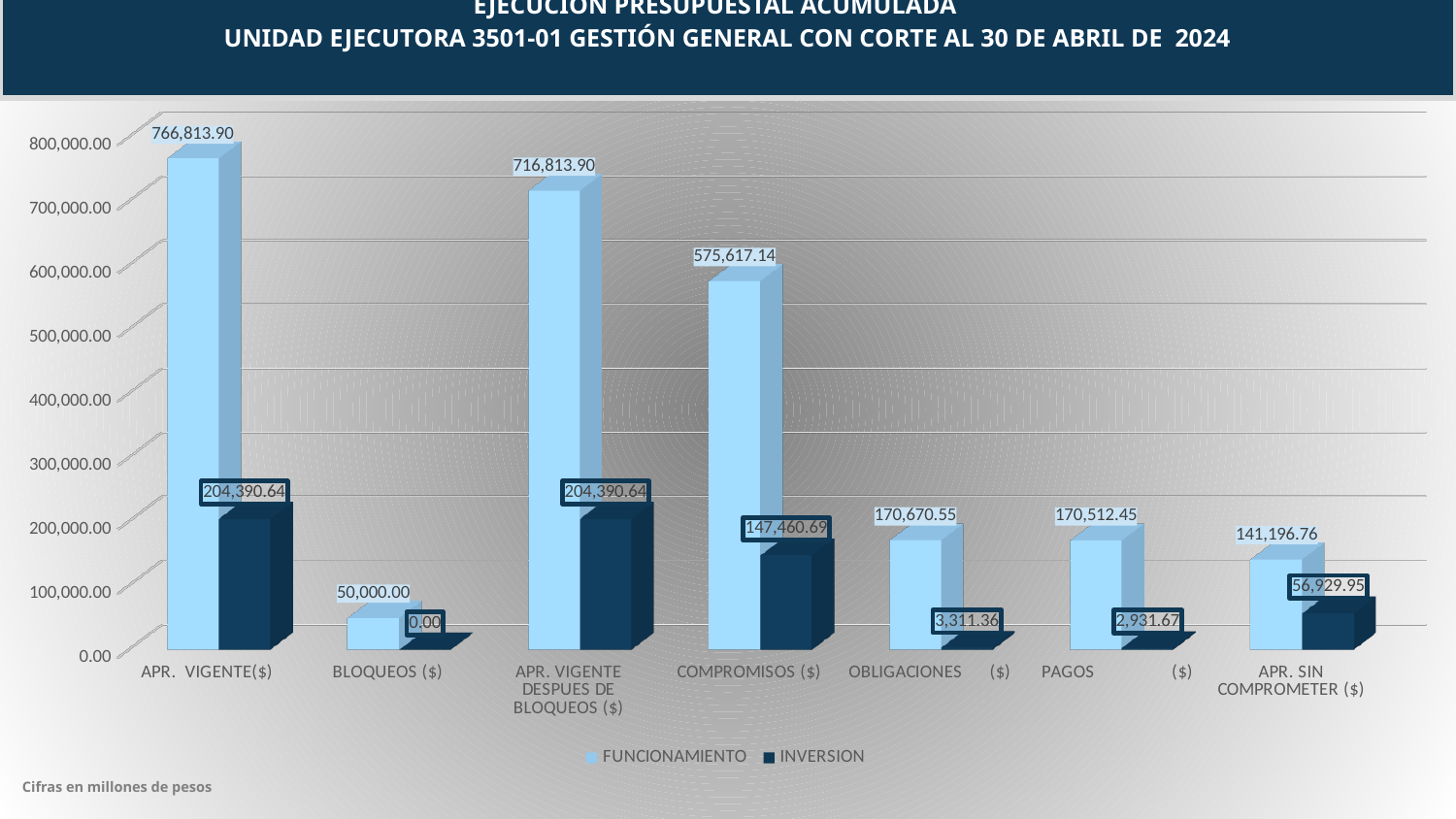
What is the FUNCIONAMIENTO value for APR. SIN COMPROMETER ($)? 141,196.76 What is the difference between the FUNCIONAMIENTO values for APR. VIGENTE($) and APR. VIGENTE DESPUES DE BLOQUEOS ($)? 50,000.00 Is the FUNCIONAMIENTO value for COMPROMISOS ($) greater or less than 500,000.00? greater What is the FUNCIONAMIENTO value for APR. VIGENTE($)? 766,813.90 How many categories are shown on the x axis? 7 How many series does the legend list? 2 Which category has the highest FUNCIONAMIENTO value? APR. VIGENTE($) What kind of chart is shown on the slide? bar chart What is the INVERSION value for BLOQUEOS ($)? 0.00 What is the INVERSION value for COMPROMISOS ($)? 147,460.69 Which is larger for COMPROMISOS ($): the FUNCIONAMIENTO value or the INVERSION value? FUNCIONAMIENTO Which category has the lowest INVERSION value? BLOQUEOS ($)